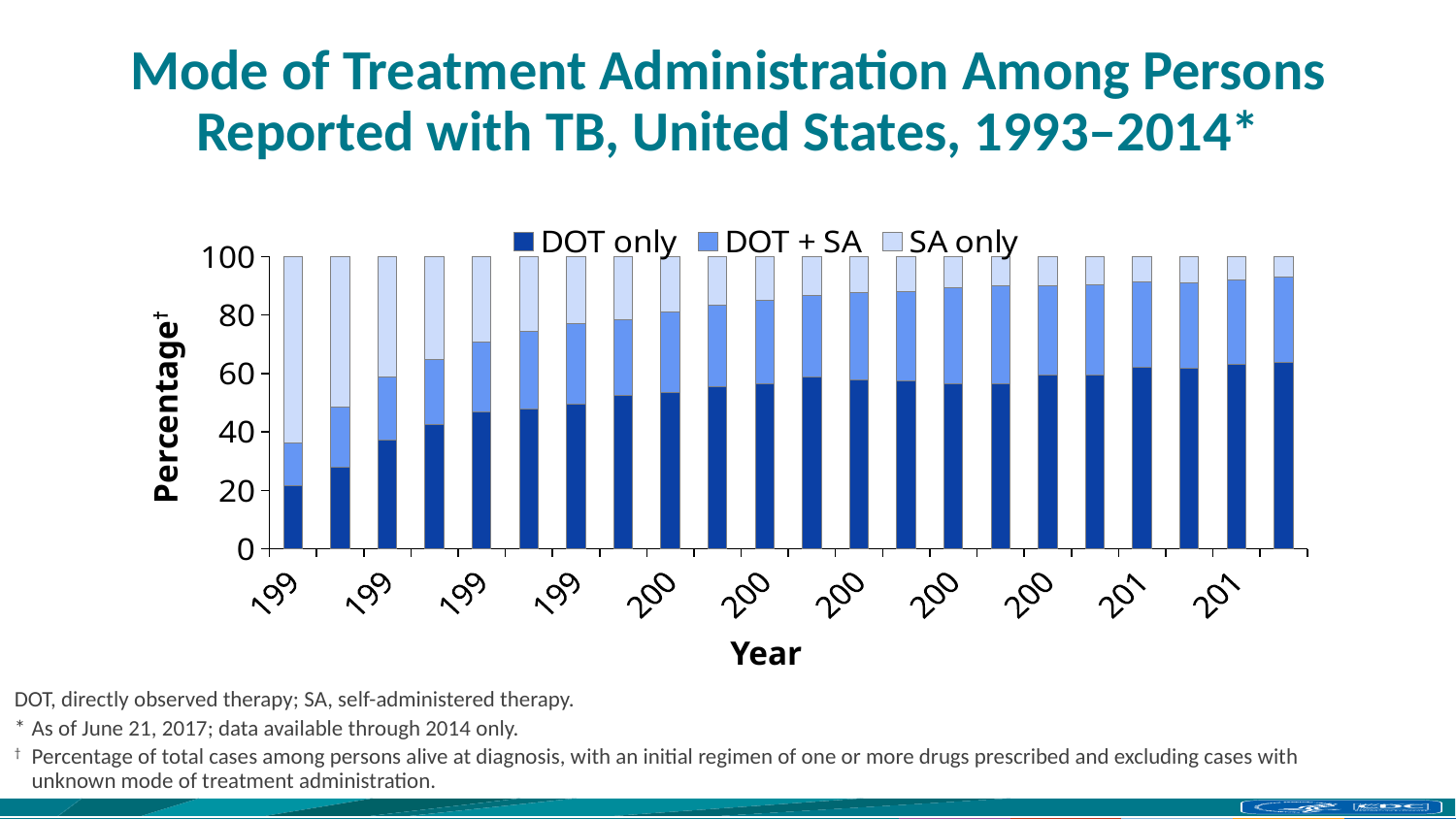
What are the three series named in the legend? DOT only, DOT + SA, SA only In the rightmost bar, which is larger: DOT only or SA only? DOT only Does the DOT only share rise or fall from the leftmost bar to the rightmost bar? Rise How many series does the legend list? 3 How many bars (years) are plotted in the chart? 22 Is the DOT only value in the rightmost bar greater or less than 60? greater What is the label of the y axis? Percentage What kind of chart is shown on the slide? Stacked bar chart In the leftmost bar, which series takes the largest share? SA only Does the SA only share rise or fall across the years from left to right? Fall What is the total height of each stacked bar? 100 Is the DOT only value in the leftmost bar greater or less than 40? less